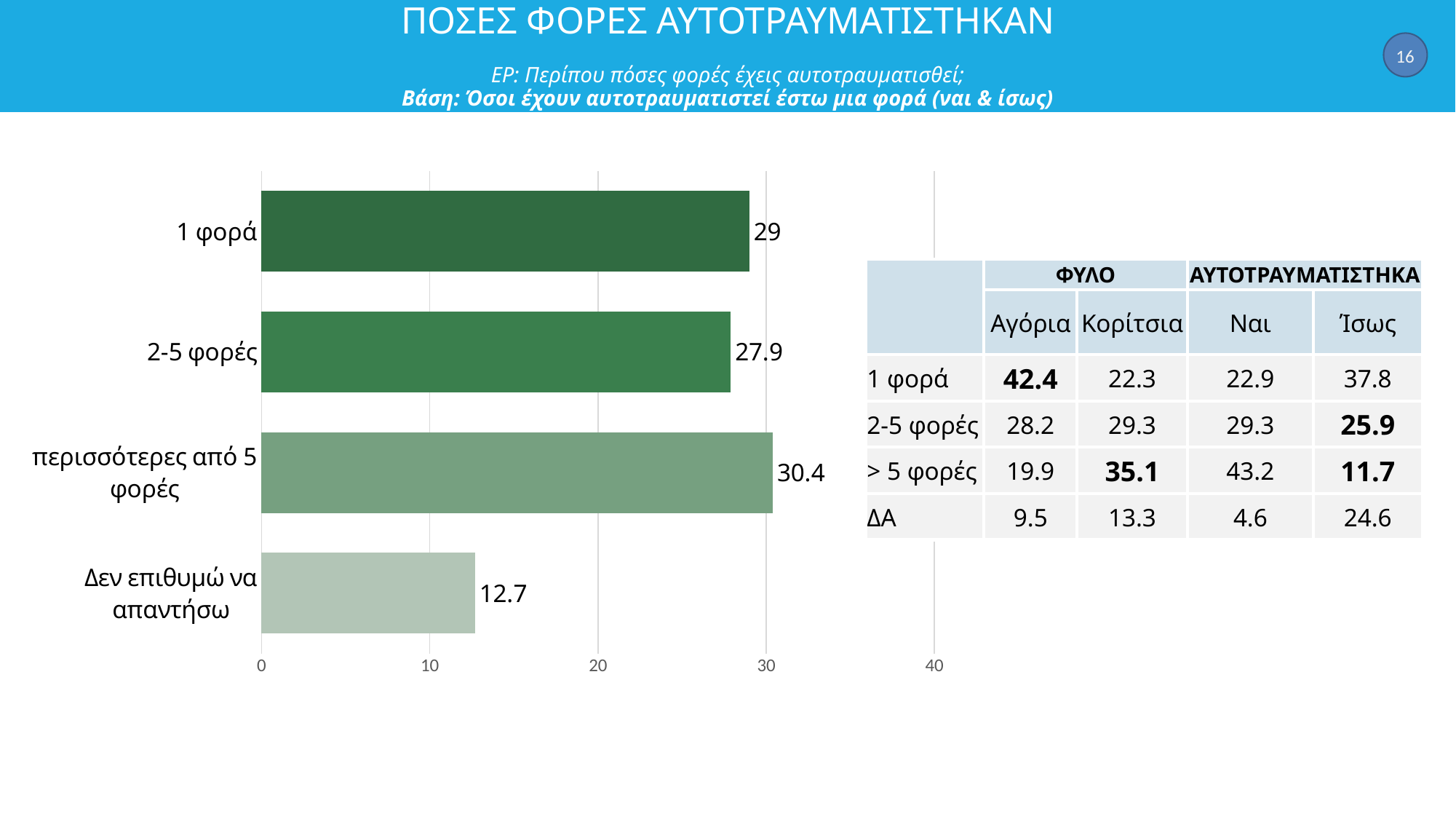
How many categories are shown in the bar chart? 4 What is the value for "2-5 φορές"? 27.9 Which is larger, the value for "1 φορά" or the value for "Δεν επιθυμώ να απαντήσω"? 1 φορά What is the value for "Δεν επιθυμώ να απαντήσω"? 12.7 What is the difference between the values for "1 φορά" and "2-5 φορές"? 1.1 What is the value for "περισσότερες από 5 φορές"? 30.4 What is the difference between the values for "περισσότερες από 5 φορές" and "Δεν επιθυμώ να απαντήσω"? 17.7 What kind of chart is shown on the slide? bar chart What is the value for "1 φορά"? 29 Is the value for "Δεν επιθυμώ να απαντήσω" greater or less than 20? less Which category has the highest value? περισσότερες από 5 φορές Which category has the lowest value? Δεν επιθυμώ να απαντήσω